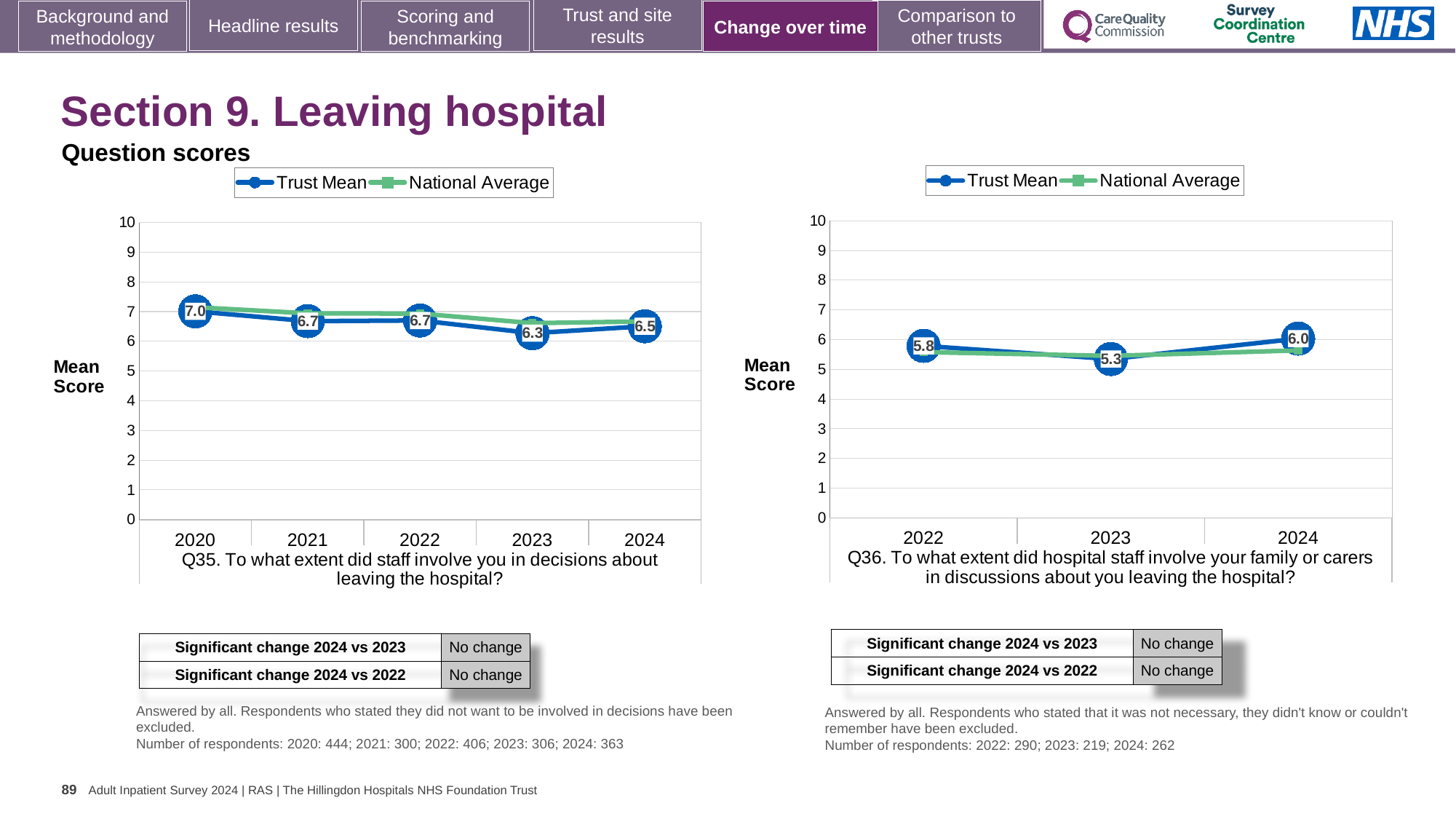
In the Q35 chart (left), what is the Trust Mean score for 2023? 6.3 In the Q35 chart (left), what is the difference between the Trust Mean scores for 2020 and 2024? 0.5 In the Q35 chart (left), what is the Trust Mean score for 2020? 7.0 In the Q36 chart (right), what is the Trust Mean score for 2024? 6.0 In the Q36 chart (right), what is the difference between the Trust Mean scores for 2024 and 2023? 0.7 What type of chart is used for Q35 (left)? Line chart In the Q36 chart (right), which year has the lowest Trust Mean score? 2023 In the Q35 chart (left), is the Trust Mean score higher in 2021 or in 2023? 2021 In the Q35 chart (left), which year has the highest Trust Mean score? 2020 How many series does the legend of the Q35 chart (left) list? 2 How many years are plotted on the x axis of the Q36 chart (right)? 3 In the Q36 chart (right), what is the Trust Mean score for 2023? 5.3